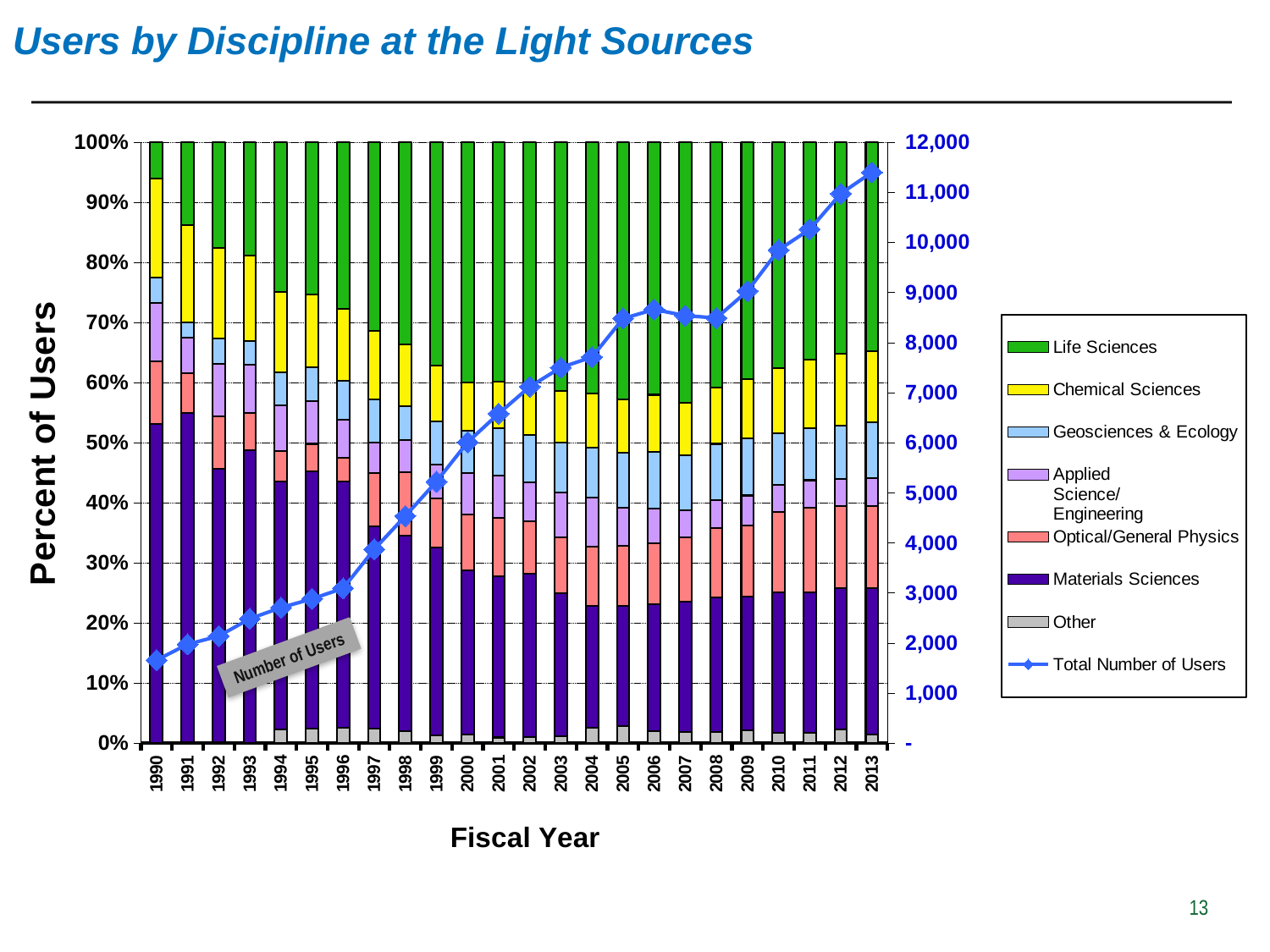
Is the Life Sciences share of users in 1990 greater or less than 10%? less What kind of chart is shown on the slide? Stacked bar chart with a line How many fiscal years are shown on the x axis? 24 Which fiscal year has the lowest Total Number of Users? 1990 Does the Total Number of Users generally rise or fall from 1990 to 2013? Rise Is the Materials Sciences share of users in 1991 greater or less than 50%? greater How many entries does the legend list? 8 Which is larger, the Total Number of Users in 2005 or in 1995? 2005 Is the Total Number of Users in 2013 greater or less than 11,000? greater Which fiscal year has the highest Total Number of Users? 2013 What is the title of the chart on the slide? Users by Discipline at the Light Sources